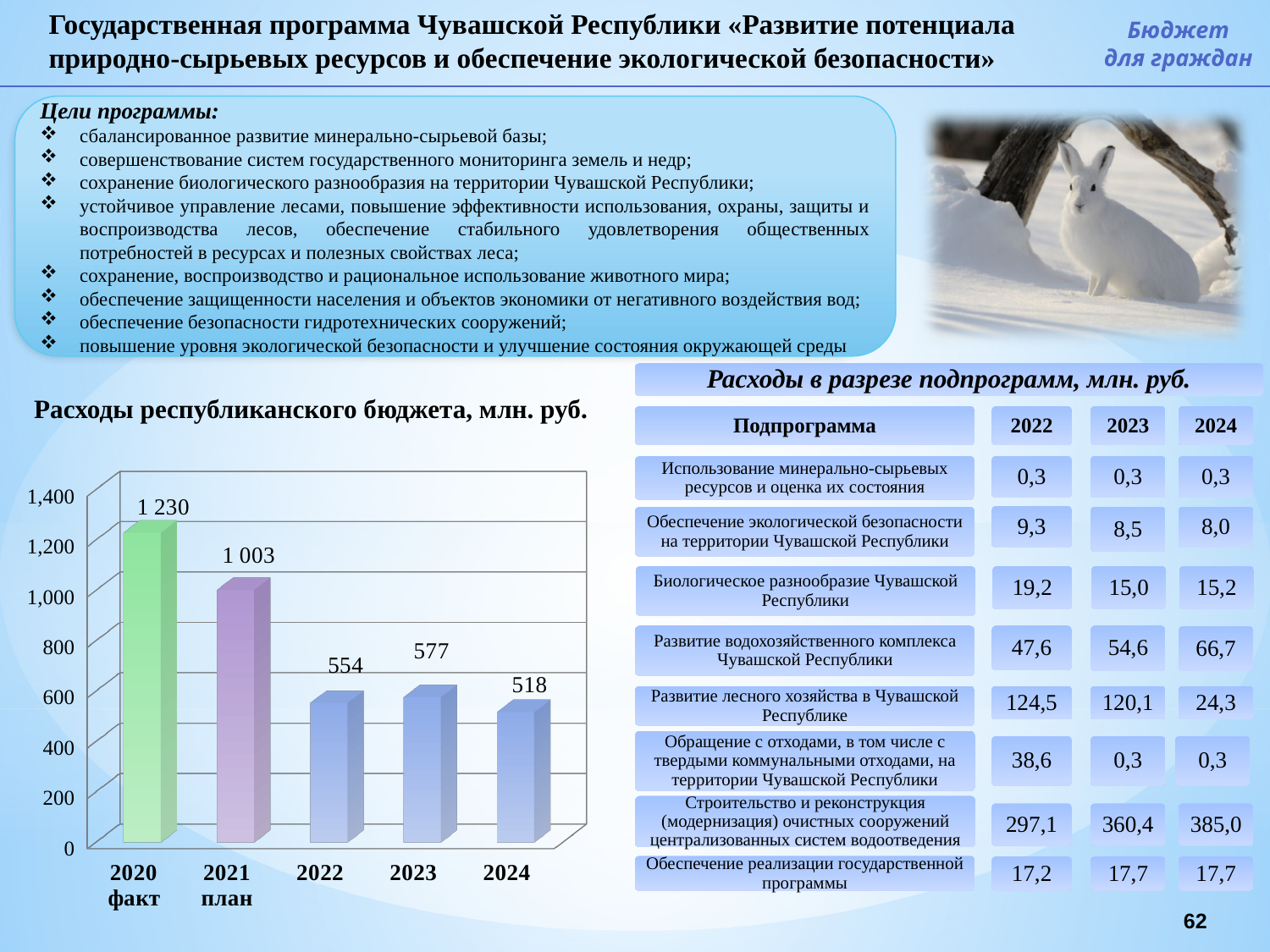
What is the difference between the values for 2023 and 2024? 59 Which is larger, the value for 2022 or the value for 2023? 2023 What kind of chart is shown on the slide? bar chart What is the value for 2024 in the chart? 518 Which category has the lowest value in the chart? 2024 What is the value for 2020 факт in the chart 'Расходы республиканского бюджета, млн. руб.'? 1 230 Is the value for 2021 план greater or less than 1,200? less What is the value for 2022 in the chart? 554 How many categories are shown on the x axis of the chart? 5 What is the value for 2021 план in the chart? 1 003 Which category has the highest value in the chart? 2020 факт What is the difference between the values for 2020 факт and 2021 план? 227